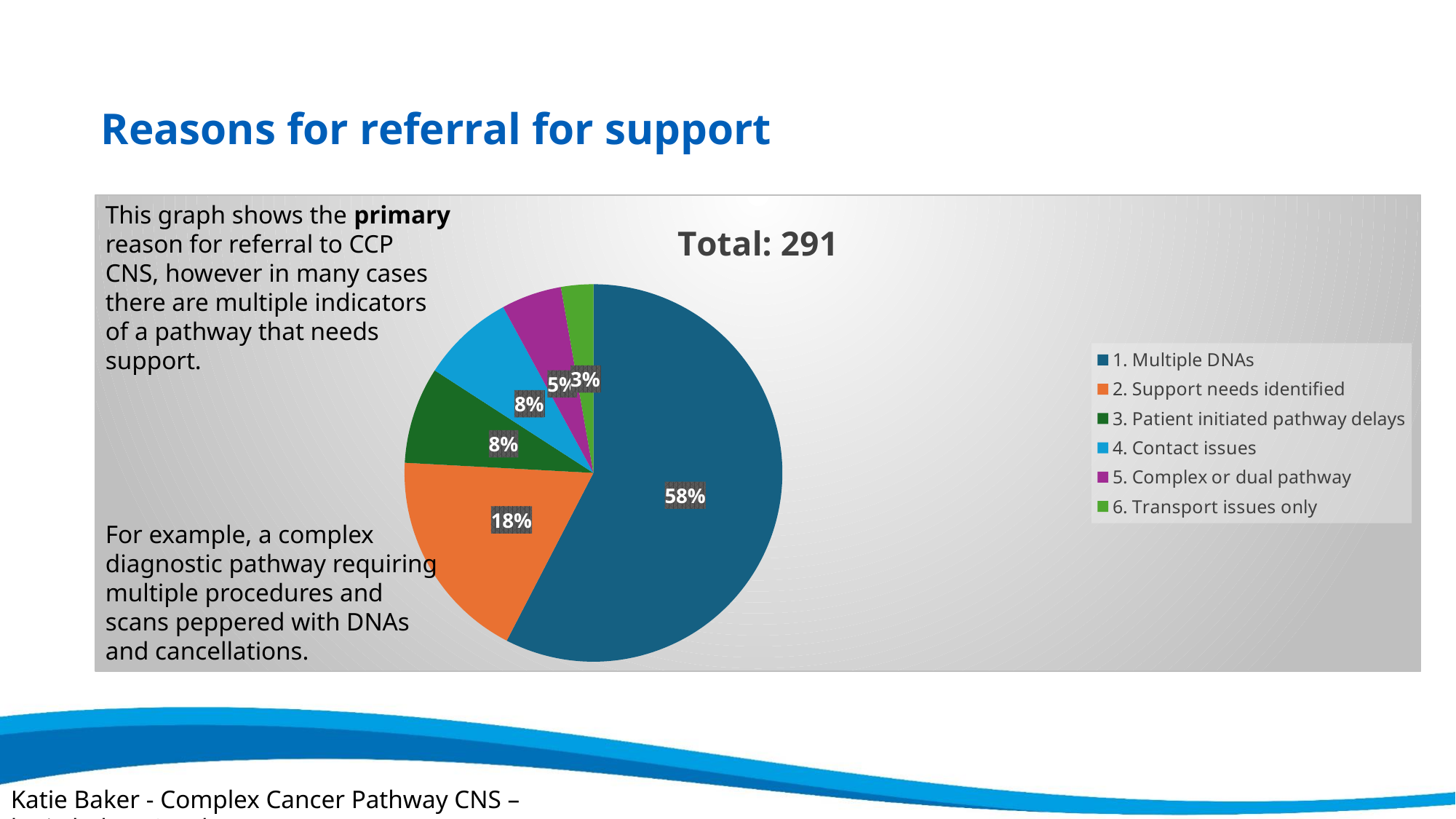
What share of the pie is '2. Support needs identified'? 18% What share of the pie is '6. Transport issues only'? 3% What kind of chart is shown on the slide? pie chart Which is larger, the slice for '2. Support needs identified' or the slice for '5. Complex or dual pathway'? 2. Support needs identified How many categories does the legend list? 6 What share of the pie is '1. Multiple DNAs'? 58% What is the title of the chart? Total: 291 Which category has the largest slice of the pie? 1. Multiple DNAs What is the difference in percentage points between '1. Multiple DNAs' and '2. Support needs identified'? 40 Which category has the smallest slice of the pie? 6. Transport issues only